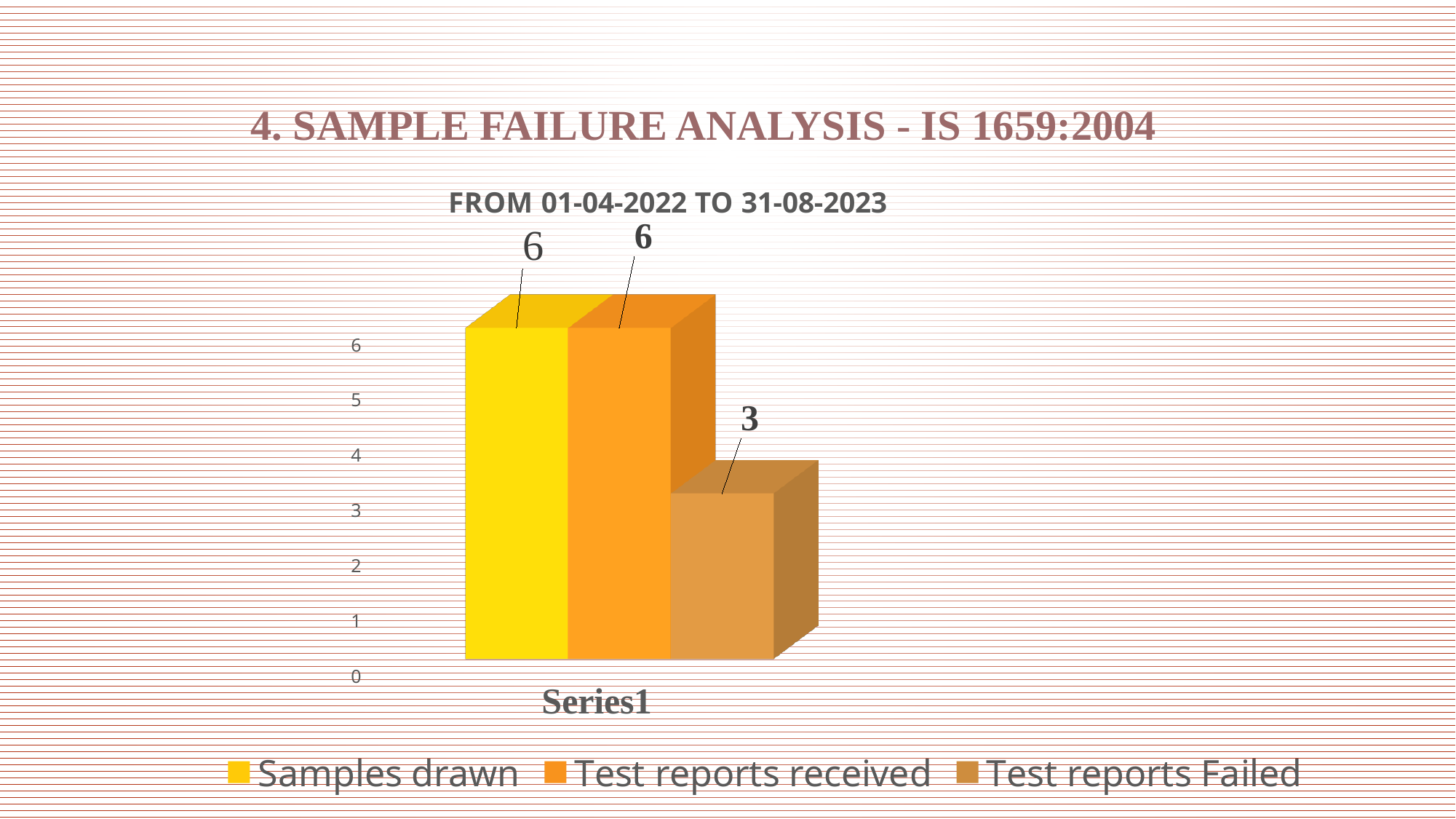
What is the highest value shown on the vertical axis? 6 What is the category label on the x axis? Series1 Is the value for Test reports Failed greater or less than 4? less What is the value for Test reports received? 6 How many series does the legend list? 3 What kind of chart is shown? bar chart What is the difference between Test reports received and Test reports Failed? 3 What is the value for Test reports Failed? 3 What is the value for Samples drawn? 6 What is the title of the chart? FROM 01-04-2022 TO 31-08-2023 Which is larger, Samples drawn or Test reports Failed? Samples drawn Which series has the lowest value? Test reports Failed